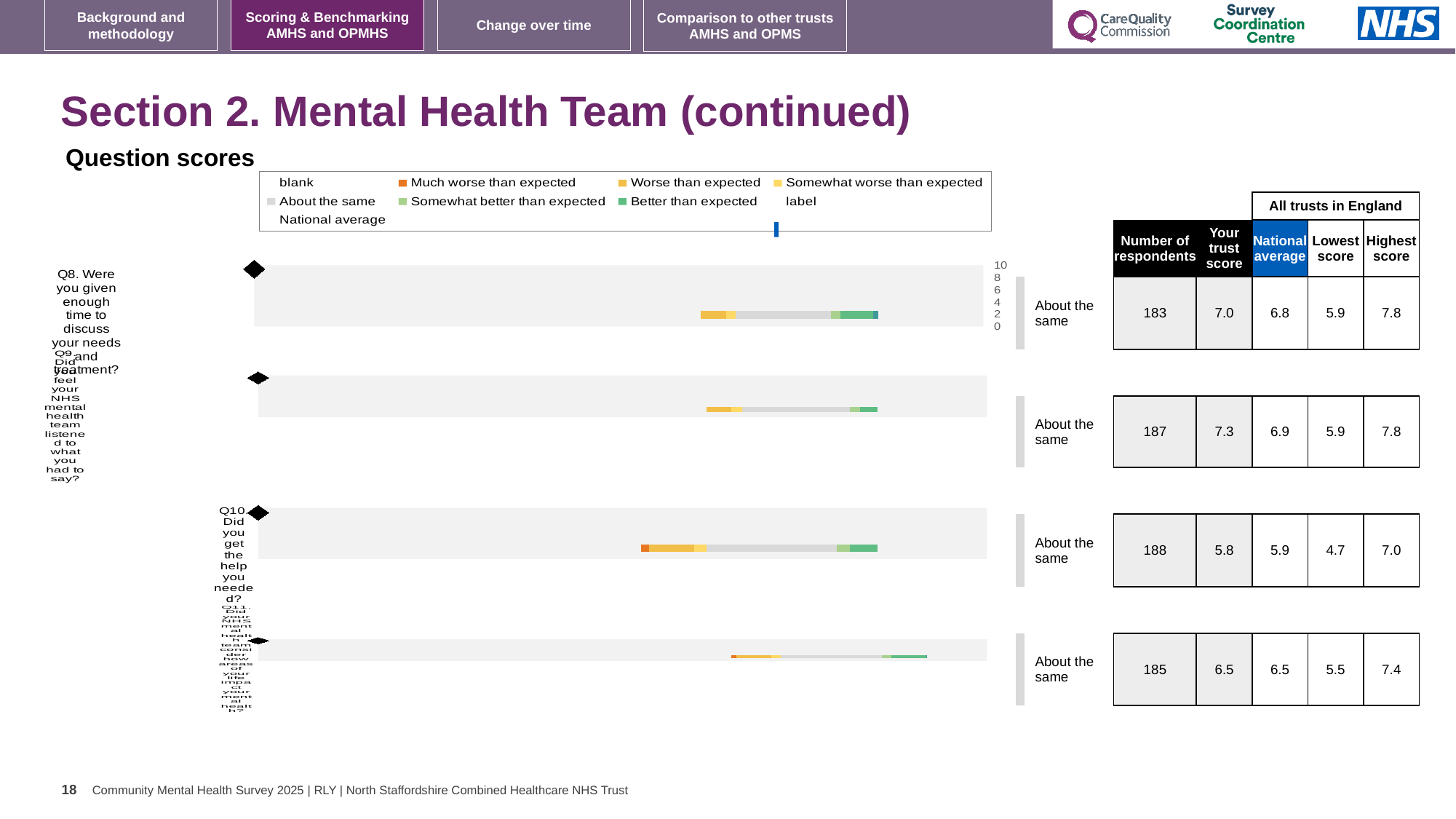
What category label is printed to the right of the Q10 chart? About the same Which legend entry is shown in grey in the question-score charts? About the same What kind of chart is used for the question scores on this slide? bar chart What is the highest tick value shown on the axis of the Q8 chart? 10 How many question-score bar charts are shown on the slide? 4 How many entries does the legend above the question-score charts list? 9